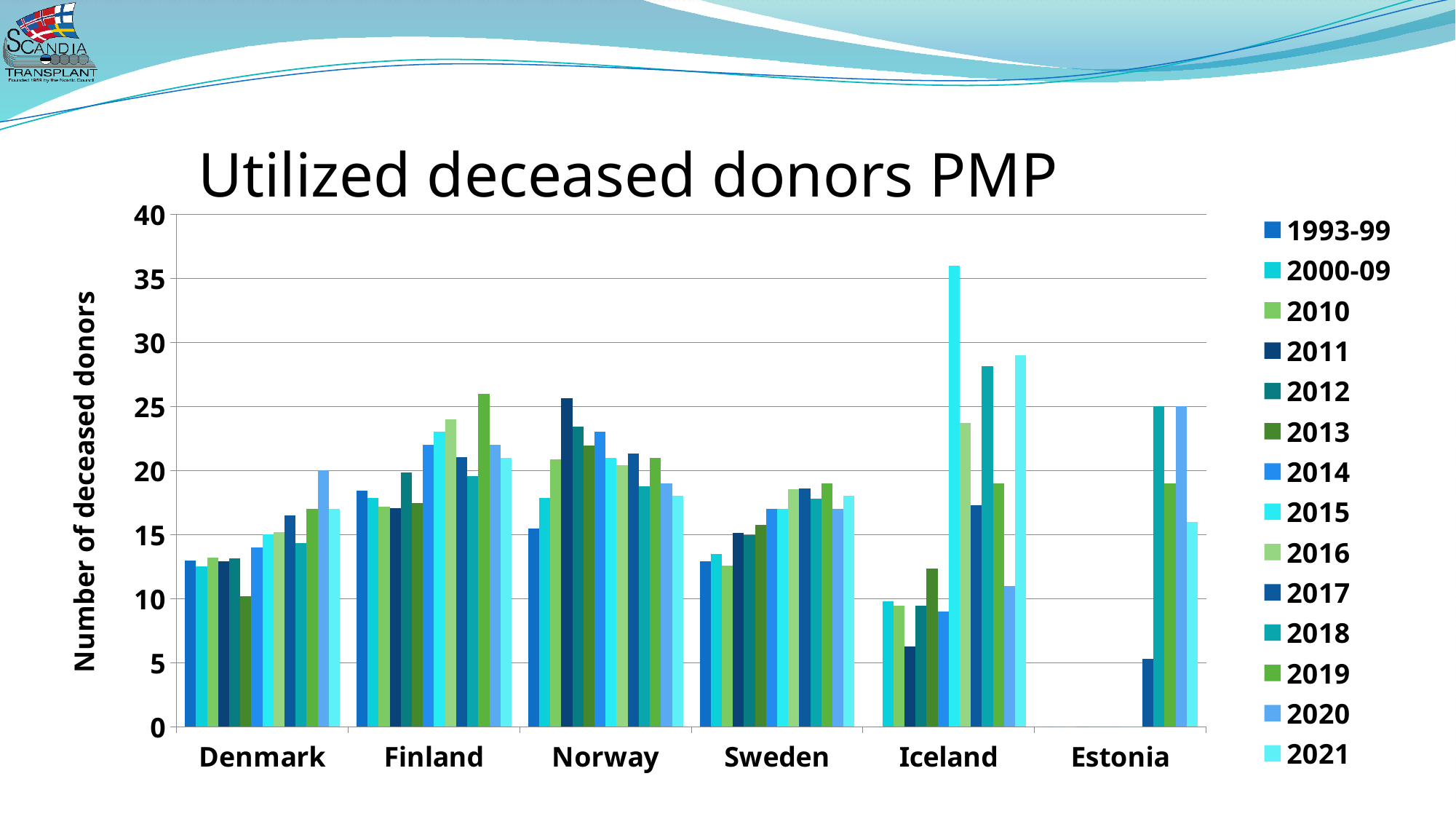
Is the value for Norway in 2011 greater or less than 25? greater What kind of chart is shown on the slide? bar chart Which is larger, the 2021 value for Denmark or the 2021 value for Finland? Finland Is the value for Iceland in 2011 greater or less than 10? less Is the value for Sweden in 2010 greater or less than 15? less Which country has the tallest bar in the chart? Iceland What is the title of the chart? Utilized deceased donors PMP How many countries are shown on the x axis of the chart? 6 How many series does the legend list? 14 For Denmark, which period has the highest value? 2020 What is the label of the vertical axis? Number of deceased donors